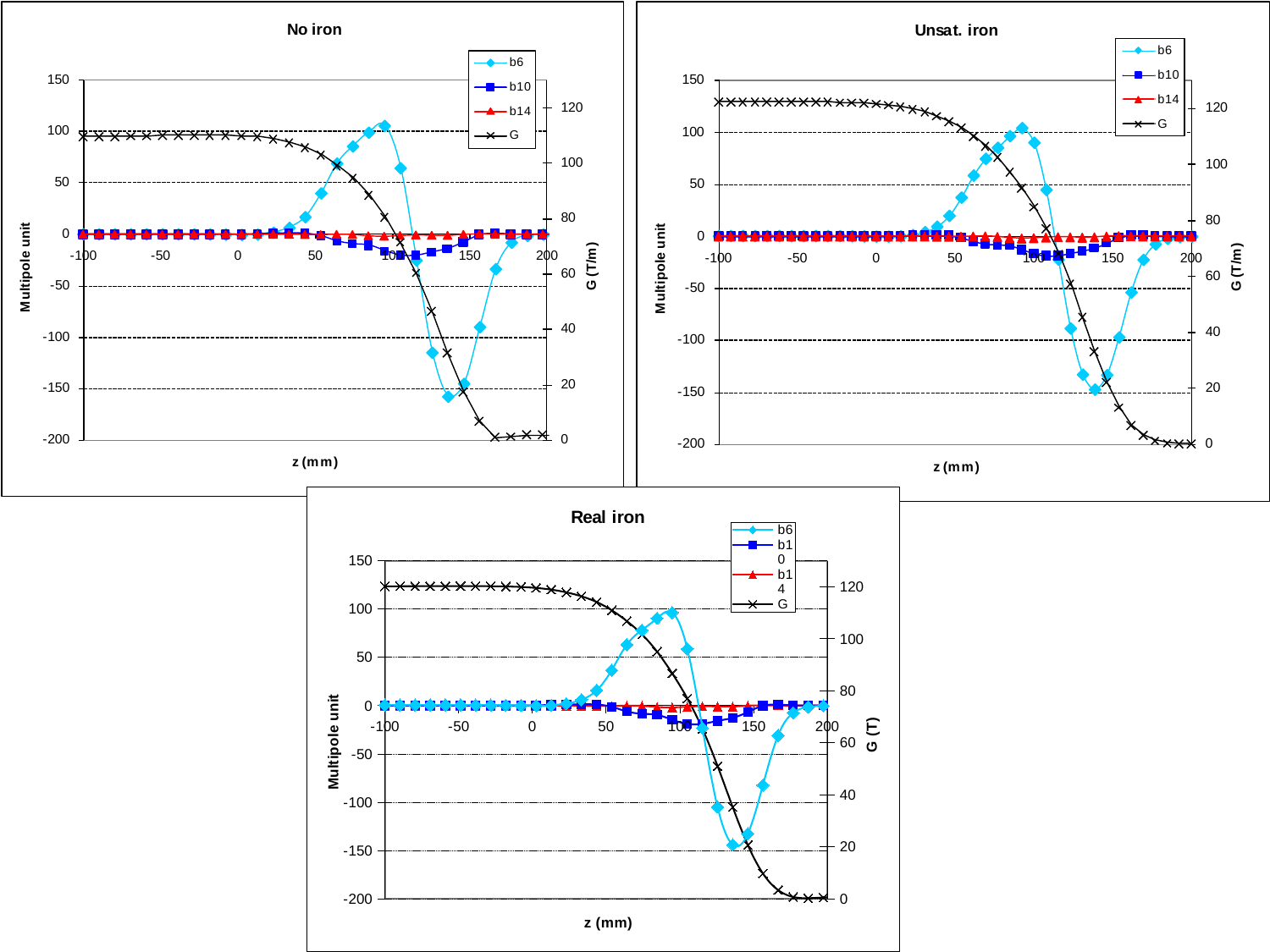
In the "No iron" chart, is the lowest value of the b6 series greater or less than -100? less In the "Real iron" chart, is the G value at z = 200 mm greater or less than 20 on the right axis? less In the "No iron" chart, is the G value at z = -100 mm greater or less than 100 on the right axis? greater What are the legend entries of the "No iron" chart? b6, b10, b14, G What kind of chart is the "No iron" chart? line chart How many charts are shown on the slide? 3 In the "No iron" chart, does the G series rise or fall as z goes from 0 mm to 200 mm? fall How many series does the legend of the "Unsat. iron" chart list? 4 What is the label of the right-hand vertical axis of the "Real iron" chart? G (T)